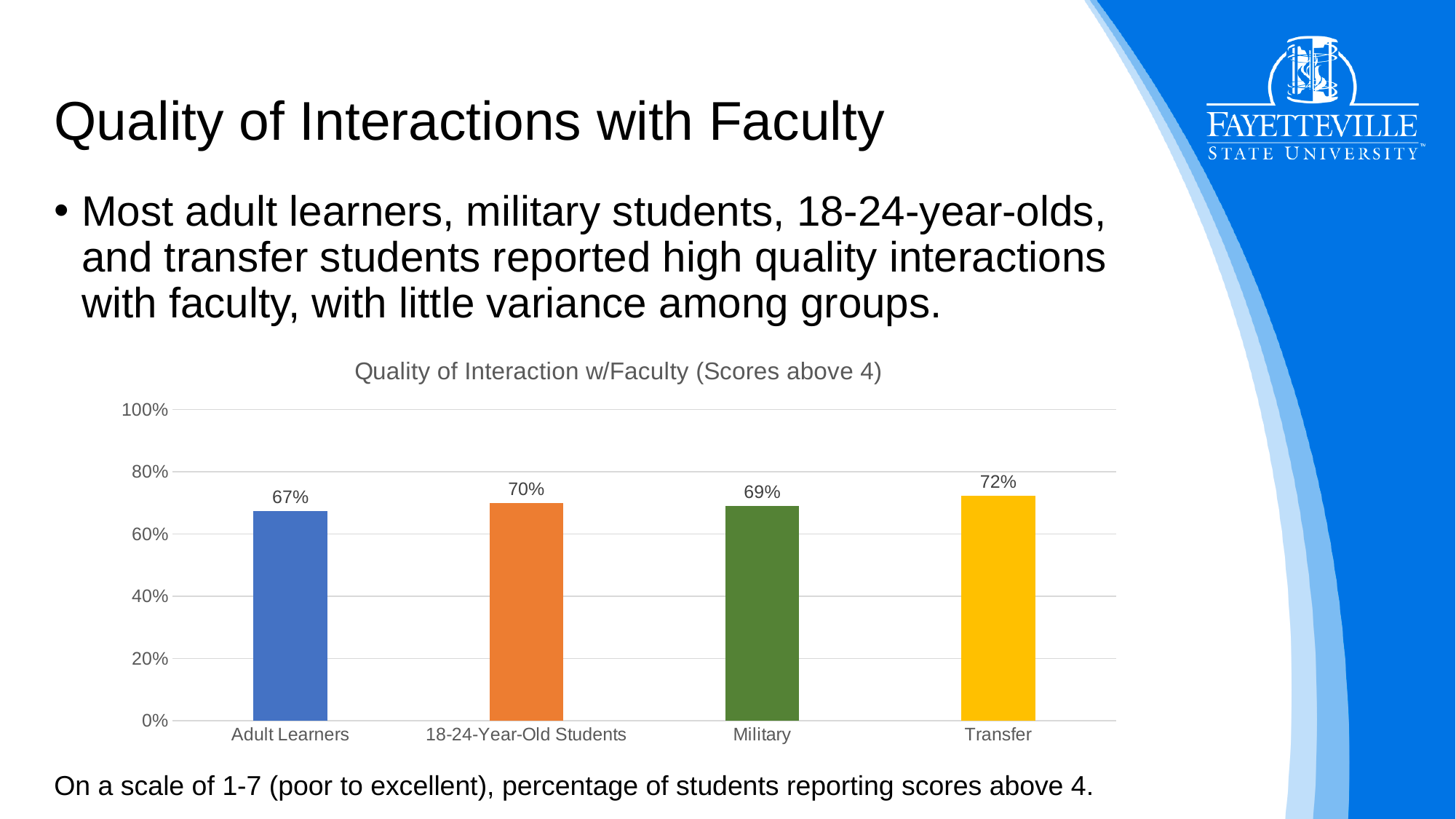
What is the value for 18-24-Year-Old Students? 70% What is the difference between the values for Transfer and Adult Learners? 5% What is the difference between the values for 18-24-Year-Old Students and Military? 1% Which category has the highest value? Transfer What kind of chart is shown on the slide? Bar chart What is the value for Adult Learners? 67% What is the value for Transfer? 72% What is the title of the chart? Quality of Interaction w/Faculty (Scores above 4) What is the value for Military? 69% Is the value for Military greater or less than 80%? less How many categories are shown in the chart? 4 Which category has the lowest value? Adult Learners